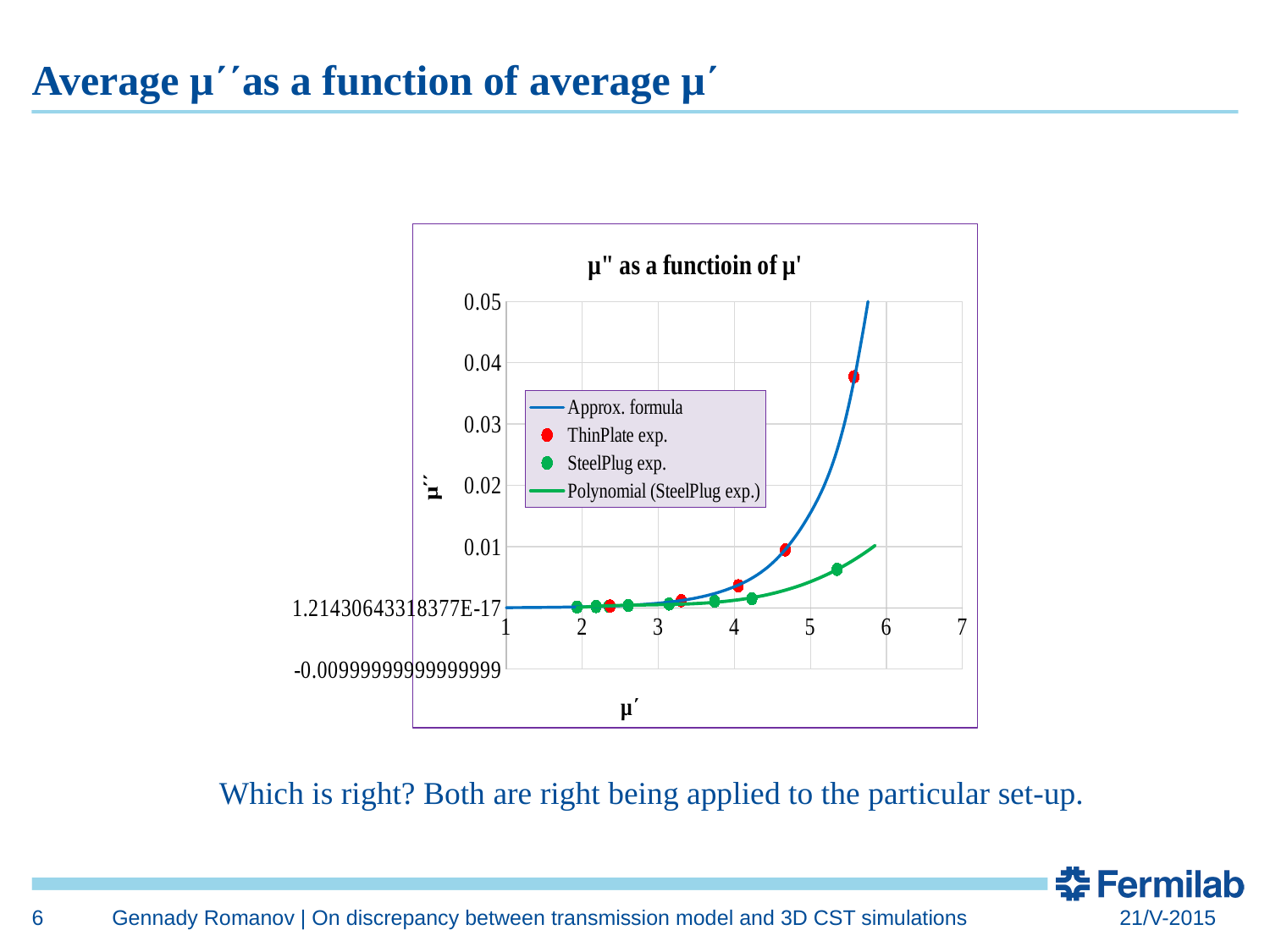
What is the title of the chart? μ" as a functioin of μ' Do the values of the Approx. formula curve rise or fall as μ′ increases? rise Near μ′ = 5.5, which series has the larger μ″ value: ThinPlate exp. or SteelPlug exp.? ThinPlate exp. Is the highest ThinPlate exp. point (near μ′ = 5.6) greater or less than 0.04? less Is the highest SteelPlug exp. point (near μ′ = 5.4) greater or less than 0.01? less Is the highest ThinPlate exp. point (near μ′ = 5.6) greater or less than 0.03? greater What is the largest value shown on the vertical axis? 0.05 How many series does the legend list? 4 Do the SteelPlug exp. points rise or fall as μ′ increases? rise Which legend entry is drawn as a green line? Polynomial (SteelPlug exp.) What kind of chart is shown on the slide? scatter chart with fitted lines